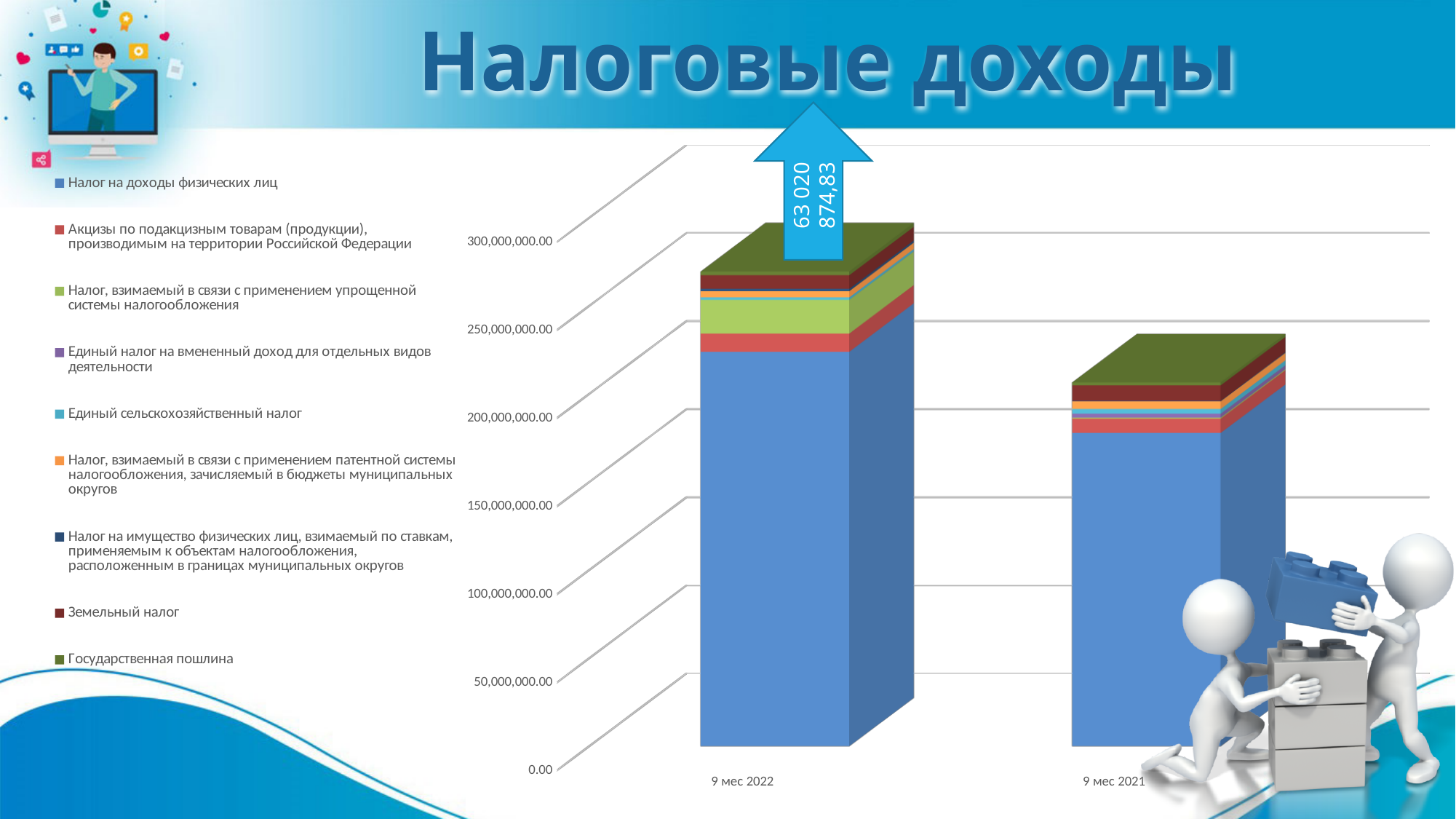
Which bar is taller, 9 мес 2022 or 9 мес 2021? 9 мес 2022 Is the total value for 9 мес 2021 greater or less than 200,000,000.00? greater What is the title of the slide? Налоговые доходы What kind of chart is shown on the slide? Stacked bar chart Is the value of Налог на доходы физических лиц for 9 мес 2022 greater or less than 200,000,000.00? greater Which series makes up the largest segment of the 9 мес 2022 bar? Налог на доходы физических лиц Is the total value for 9 мес 2021 greater or less than 300,000,000.00? less How many series does the legend list? 9 How many categories (bars) are plotted on the x axis? 2 Do the bar totals rise or fall moving from 9 мес 2022 to 9 мес 2021 along the x axis? fall What value is printed on the arrow above the 9 мес 2022 bar? 63 020 874,83